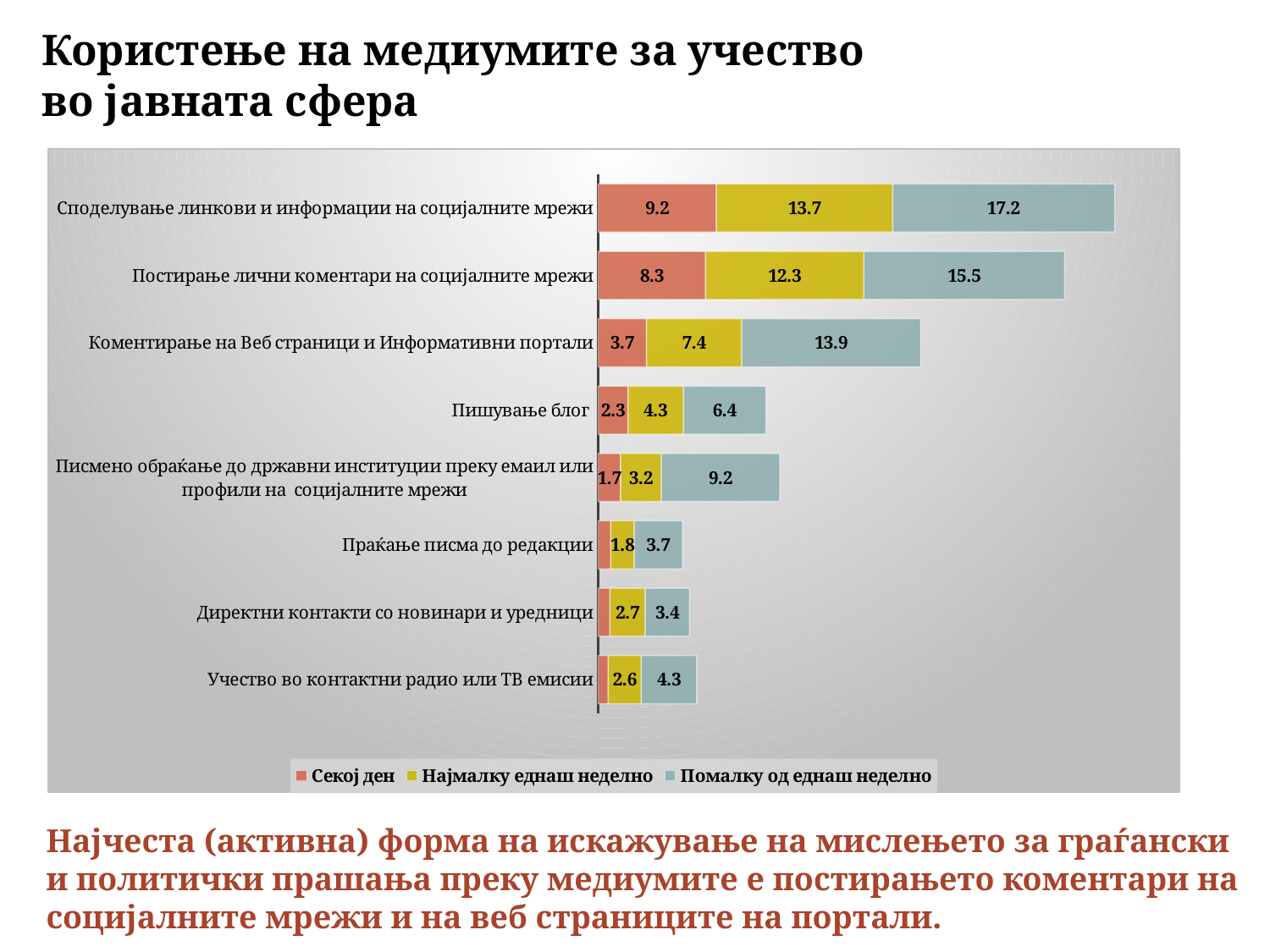
Which category has the highest value for the "Помалку од еднаш неделно" series? Споделување линкови и информации на социјалните мрежи Which series is shown in yellow in the legend? Најмалку еднаш неделно What is the difference between the "Помалку од еднаш неделно" values for "Споделување линкови и информации на социјалните мрежи" and "Постирање лични коментари на социјалните мрежи"? 1.7 What is the value of the "Најмалку еднаш неделно" series for "Коментирање на Веб страници и Информативни портали"? 7.4 What is the value of the "Помалку од еднаш неделно" series for "Пишување блог"? 6.4 Which has the larger "Помалку од еднаш неделно" value: "Пишување блог" or "Писмено обраќање до државни институции преку емаил или профили на социјалните мрежи"? Писмено обраќање до државни институции преку емаил или профили на социјалните мрежи How many categories are shown in the chart? 8 Which category has the lowest value for the "Најмалку еднаш неделно" series? Праќање писма до редакции What kind of chart is shown on the slide? Stacked bar chart What is the value of the "Секој ден" series for "Споделување линкови и информации на социјалните мрежи"? 9.2 How many series does the legend list? 3 What is the total of the stacked bar for "Споделување линкови и информации на социјалните мрежи"? 40.1